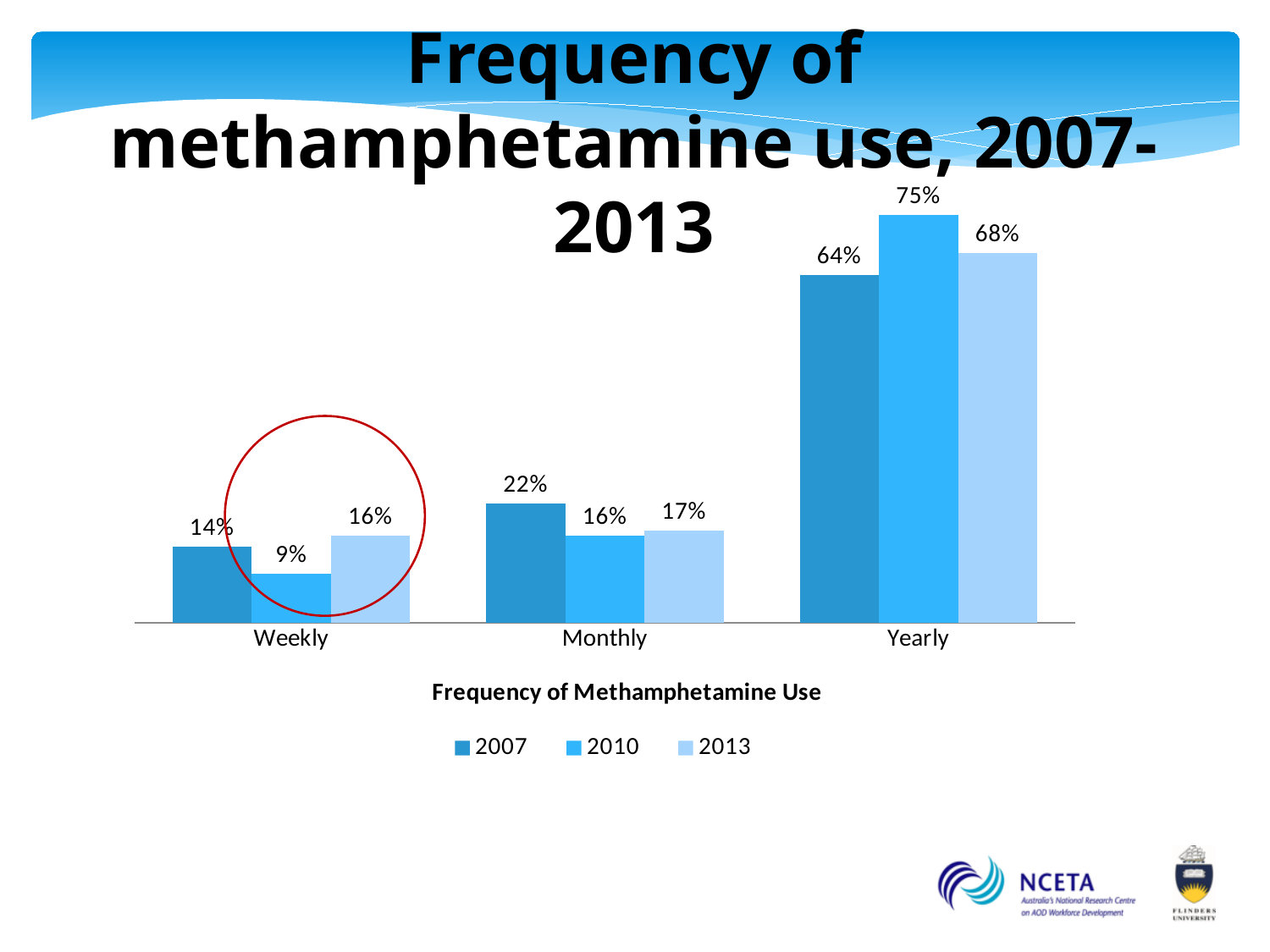
How many series does the legend list? 3 What is the value for Monthly in 2007? 22% How many categories are shown on the x axis? 3 What is the x-axis title of the chart? Frequency of Methamphetamine Use Which category has the highest value for 2010? Yearly Which is larger for Monthly: the 2007 value or the 2013 value? 2007 What is the value for Yearly in 2013? 68% What is the difference between the 2010 and 2007 values for Yearly? 11% What is the value for Weekly in 2010? 9% What kind of chart is shown? Bar chart Which category has the lowest value for 2007? Weekly Do the 2007 values rise or fall from Weekly to Yearly? Rise